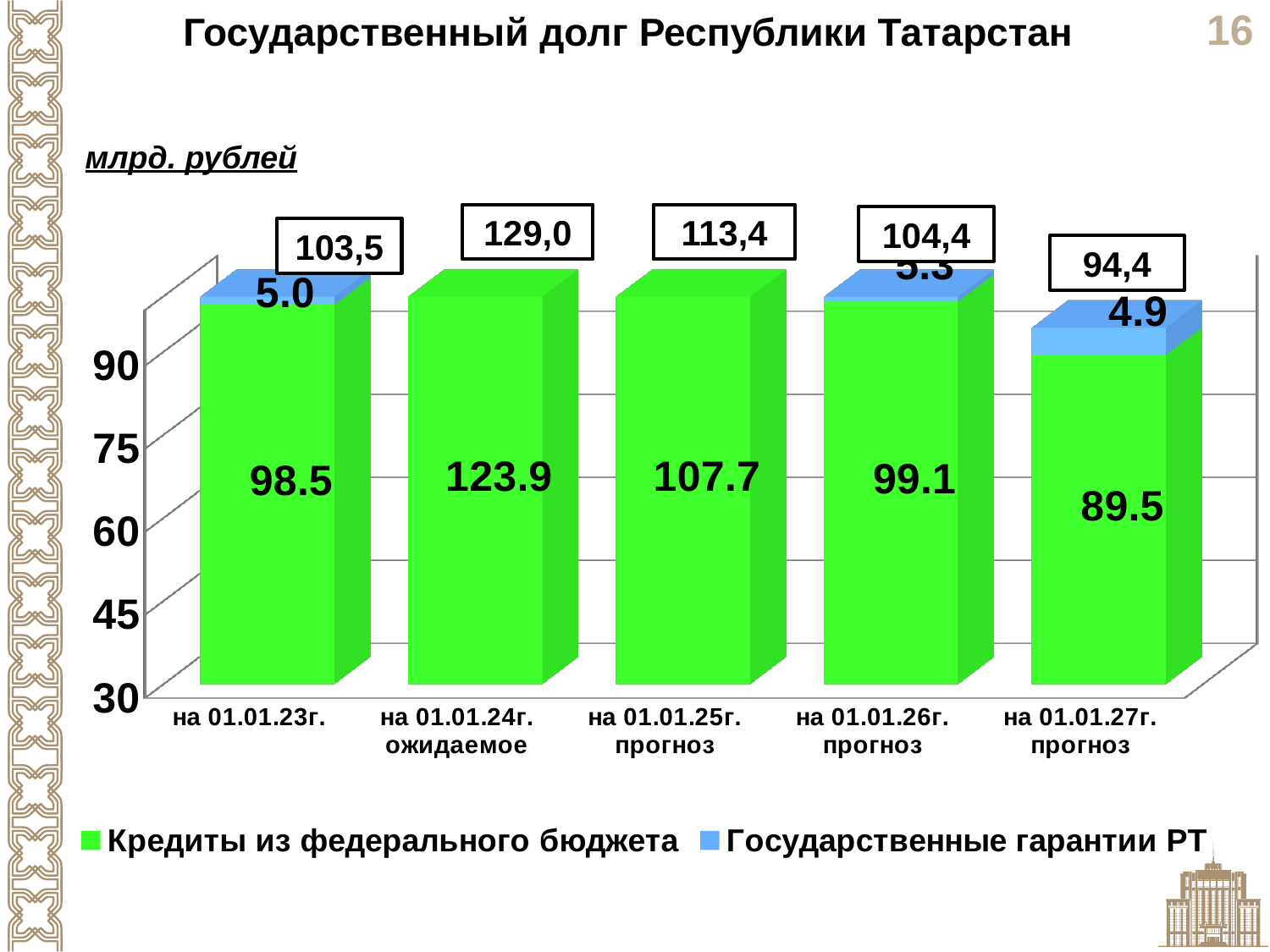
On which date is the value of Кредиты из федерального бюджета the lowest? на 01.01.27г. прогноз What is the value of Кредиты из федерального бюджета на 01.01.24г. ожидаемое? 123.9 On which date is the value of Кредиты из федерального бюджета the highest? на 01.01.24г. ожидаемое What is the title of the chart? Государственный долг Республики Татарстан Which is larger: Кредиты из федерального бюджета на 01.01.23г. or на 01.01.26г. прогноз? на 01.01.26г. прогноз How many series does the legend list? 2 How many dates (categories) are shown on the x axis? 5 What is the value of Государственные гарантии РТ на 01.01.23г.? 5.0 What type of chart is shown on the slide? bar chart What is the difference between Кредиты из федерального бюджета на 01.01.24г. ожидаемое and на 01.01.25г. прогноз? 16.2 What is the value of Кредиты из федерального бюджета на 01.01.27г. прогноз? 89.5 What is the total state debt shown above the bar for на 01.01.25г. прогноз? 113,4